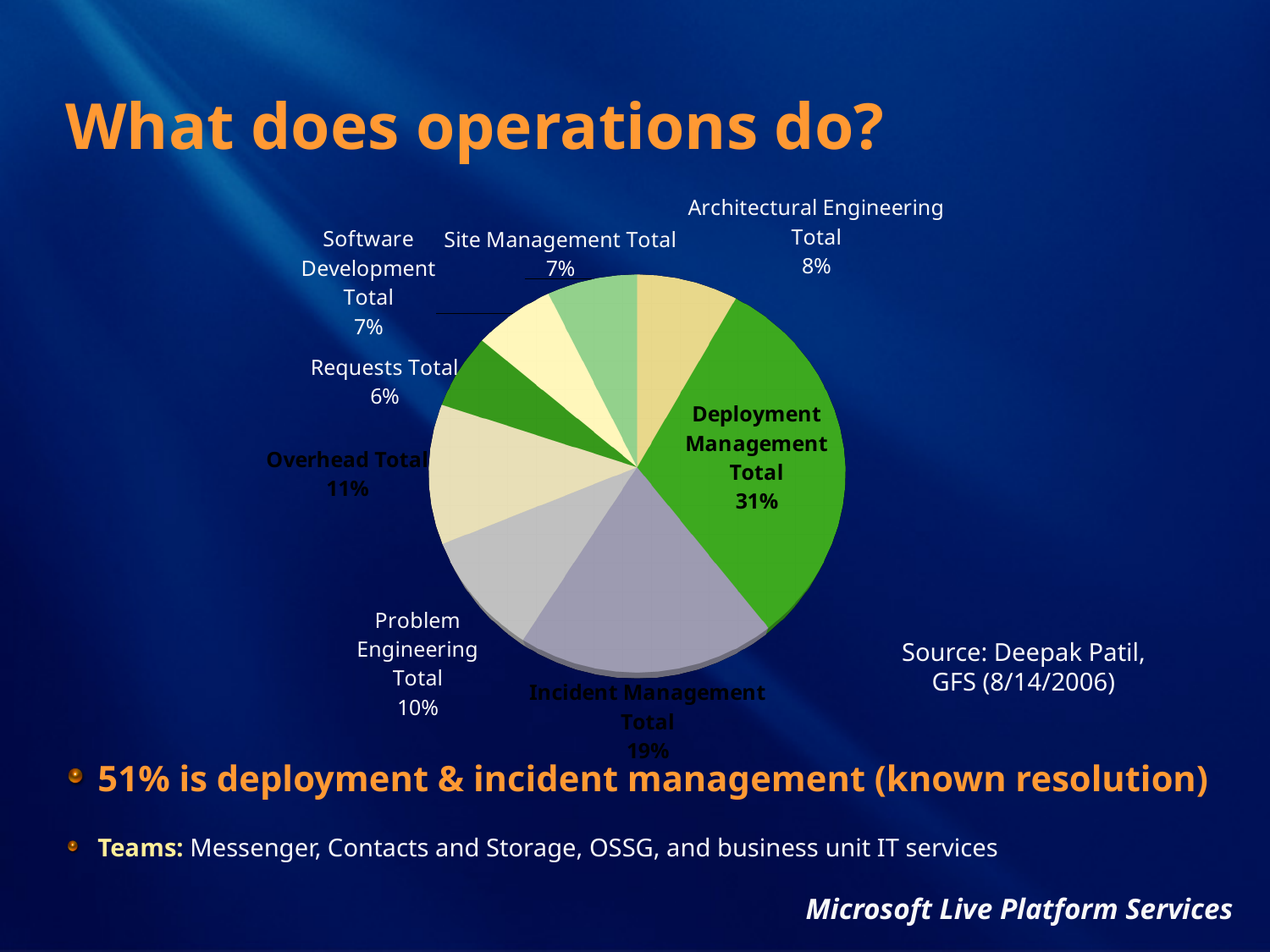
How many categories (slices) does the pie chart have? 8 Which category has the smallest slice of the pie? Requests Total What share of the pie is Problem Engineering Total? 10% Which category has the largest slice of the pie? Deployment Management Total What share of the pie is Architectural Engineering Total? 8% What share of the pie is Overhead Total? 11% What kind of chart is shown on the slide? Pie chart What is the difference in percentage points between Deployment Management Total and Incident Management Total? 12 percentage points Which is larger, Overhead Total or Problem Engineering Total? Overhead Total